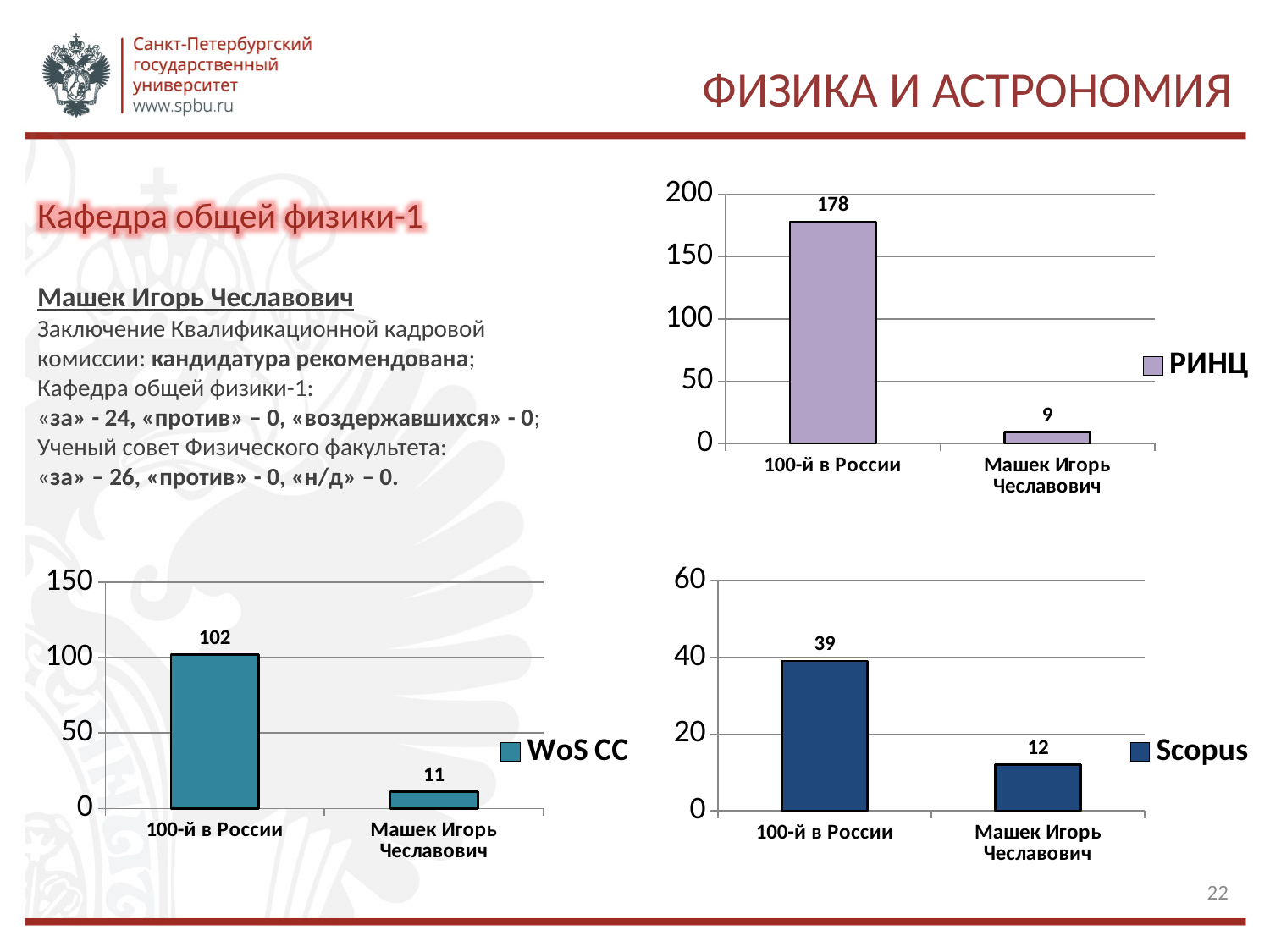
In the Scopus chart (bottom right), what is the value for Машек Игорь Чеславович? 12 What kind of chart is the Scopus chart (bottom right)? Bar chart In the РИНЦ chart (top right), what is the value for 100-й в России? 178 In the WoS CC chart (bottom left), which category has the lowest value? Машек Игорь Чеславович In the Scopus chart (bottom right), which category has the higher value? 100-й в России In the Scopus chart (bottom right), what is the value for 100-й в России? 39 In the WoS CC chart (bottom left), what is the difference between the values for 100-й в России and Машек Игорь Чеславович? 91 In the РИНЦ chart (top right), what is the value for Машек Игорь Чеславович? 9 How many categories are shown in the РИНЦ chart (top right)? 2 In the WoS CC chart (bottom left), what is the value for Машек Игорь Чеславович? 11 In the РИНЦ chart (top right), what is the difference between the values for 100-й в России and Машек Игорь Чеславович? 169 In the WoS CC chart (bottom left), what is the value for 100-й в России? 102